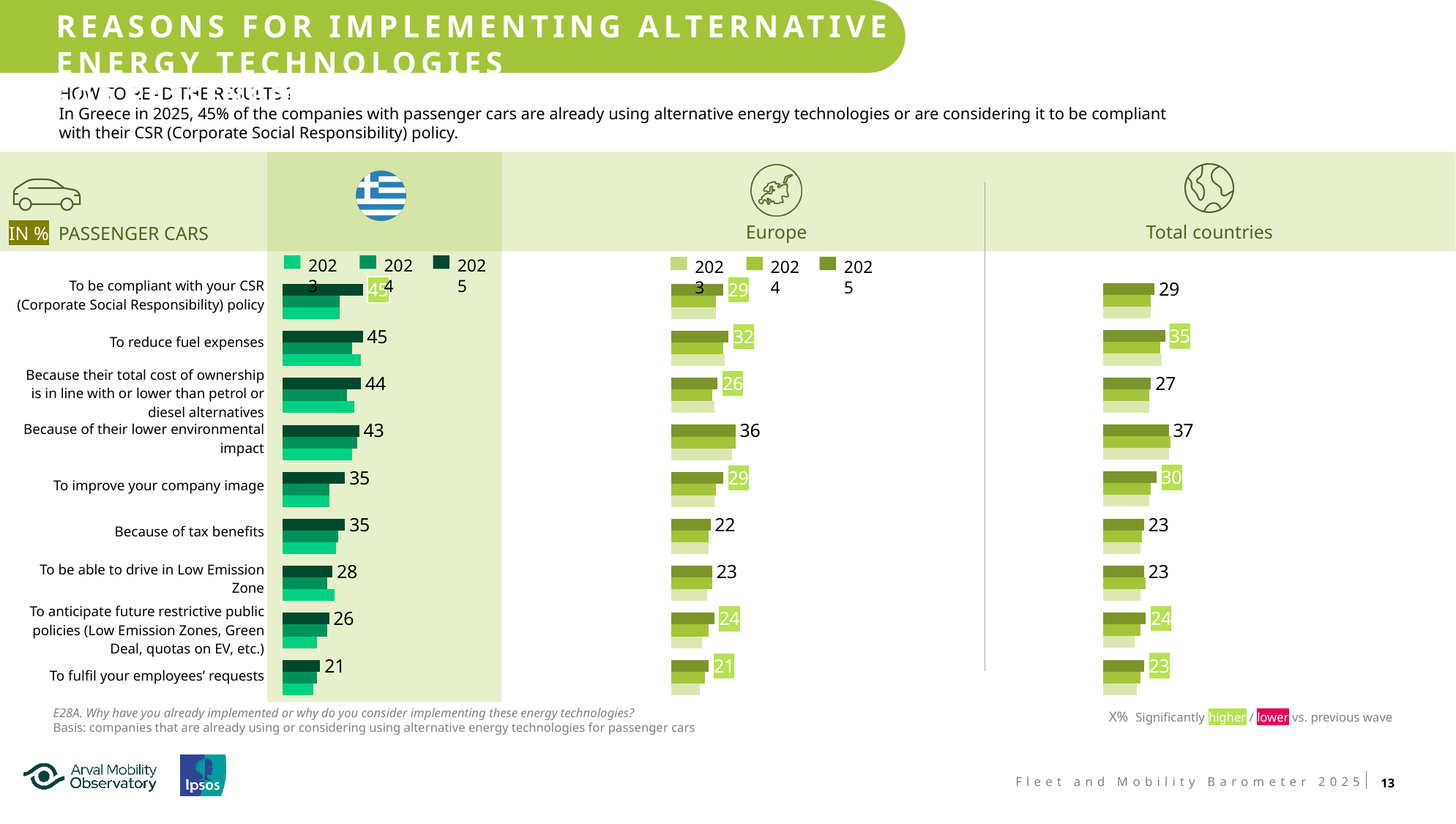
In the Total countries chart, what is the difference between the 2025 values for "Because of their lower environmental impact" and "Because of tax benefits"? 14 In the Europe chart, which reason has the highest 2025 value? Because of their lower environmental impact How many reasons (categories) are listed in the Greece chart? 9 In the Total countries chart, what is the 2025 value for "To anticipate future restrictive public policies"? 24 Which is larger in 2025: the Europe value for "To reduce fuel expenses" or the Total countries value for "To reduce fuel expenses"? Total countries In the Europe chart, what is the 2025 value for "Because of their lower environmental impact"? 36 In the Greece chart, what is the 2025 value for "To reduce fuel expenses"? 45 In the Greece chart, what is the difference between the 2025 values for "To be able to drive in Low Emission Zone" and "To fulfil your employees' requests"? 7 How many series does the legend of the Europe chart list? 3 In the Greece chart, which reason has the lowest 2025 value? To fulfil your employees' requests What kind of chart is used for the Greece data? Bar chart In the Total countries chart, what is the 2025 value for "To improve your company image"? 30